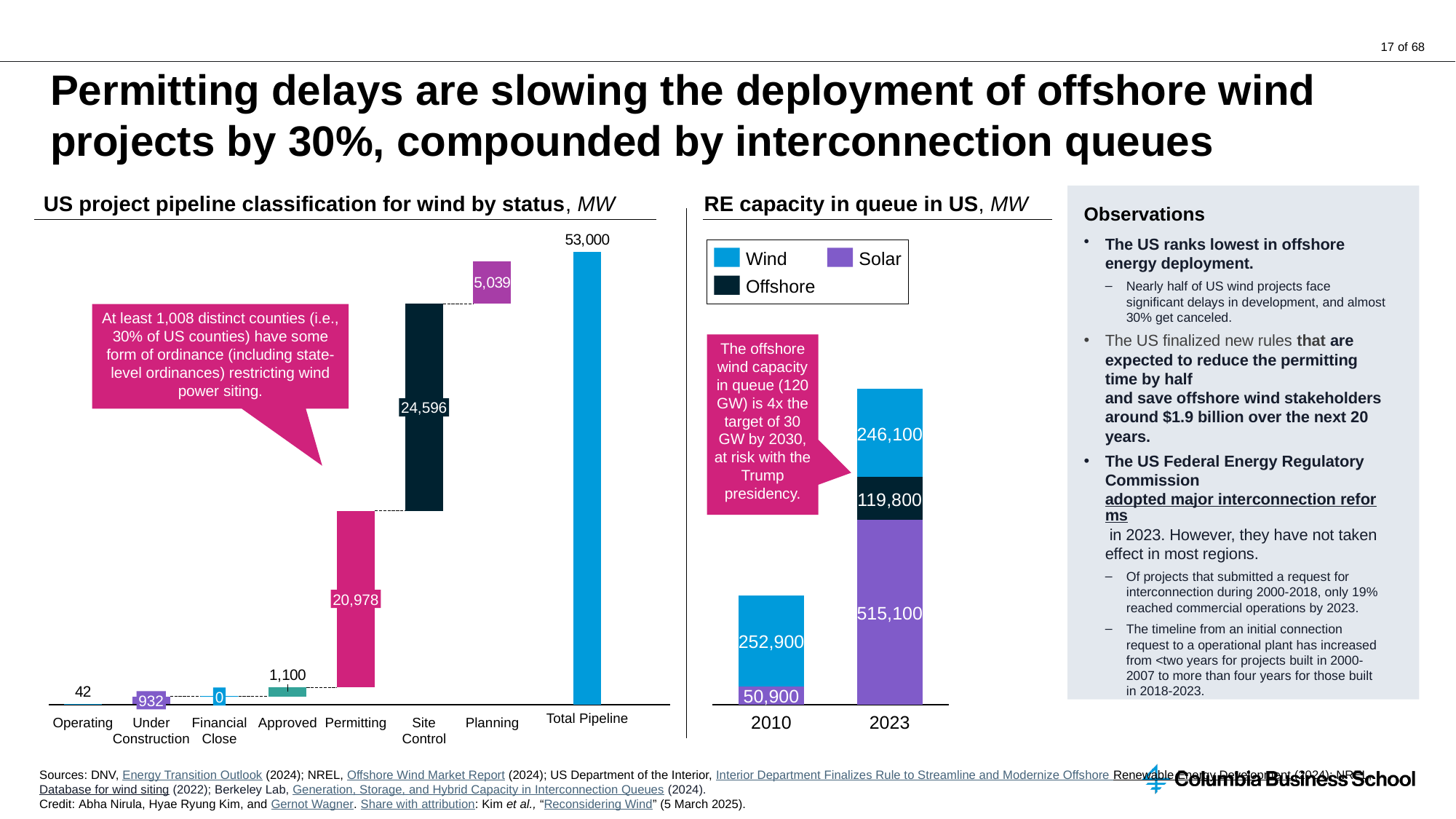
In the 'US project pipeline classification for wind by status' chart, what is the value for Permitting? 20,978 In the 'RE capacity in queue in US' chart, what is the Offshore value for 2023? 119,800 What kind of chart is the 'RE capacity in queue in US' chart? Stacked bar chart How many series does the legend of the 'RE capacity in queue in US' chart list? 3 In the 'US project pipeline classification for wind by status' chart, which status category has the lowest value? Financial Close In the 'RE capacity in queue in US' chart, what is the Solar value for 2023? 515,100 In the 'RE capacity in queue in US' chart, what is the total capacity in queue for 2010? 303,800 In the 'US project pipeline classification for wind by status' chart, what is the value for Total Pipeline? 53,000 In the 'US project pipeline classification for wind by status' chart, what is the difference between Site Control and Permitting? 3,618 How many status categories are shown on the x axis of the 'US project pipeline classification for wind by status' chart? 8 In the 'US project pipeline classification for wind by status' chart, which is larger, Under Construction or Approved? Approved In the 'US project pipeline classification for wind by status' chart, what is the value for Site Control? 24,596